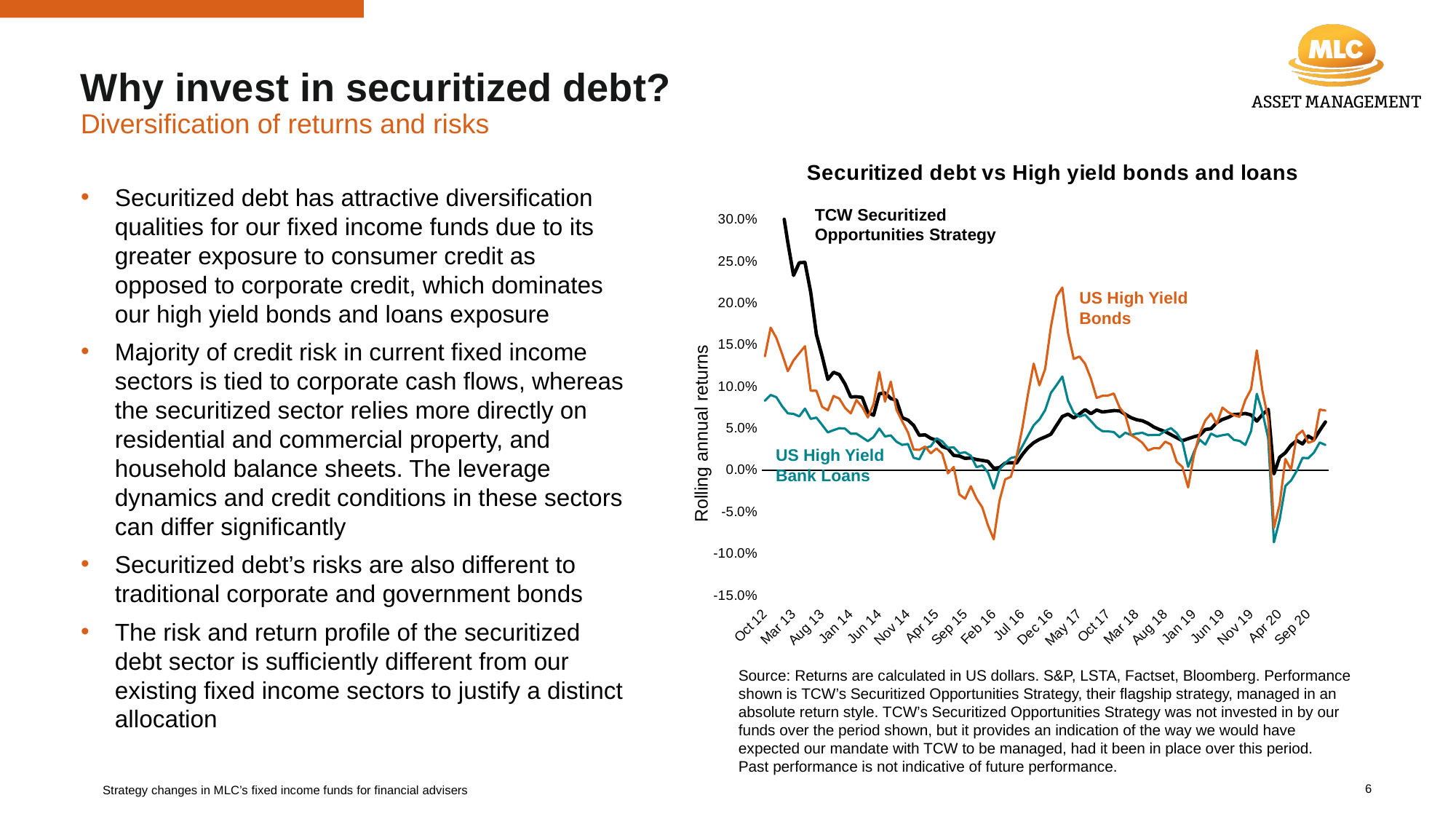
Is the value for TCW Securitized Opportunities Strategy at Oct 12 greater or less than 25.0%? greater Is the lowest value for US High Yield Bonds around Feb 16 greater or less than -5.0%? less At Oct 12, which is higher: TCW Securitized Opportunities Strategy or US High Yield Bank Loans? TCW Securitized Opportunities Strategy Which series reaches the highest value anywhere on the chart? TCW Securitized Opportunities Strategy What kind of chart is shown on the slide? line chart Does the TCW Securitized Opportunities Strategy line rise or fall from Oct 12 to Feb 16? fall Is the peak value for US High Yield Bonds around May 17 greater or less than 15.0%? greater Around May 17, which is higher: US High Yield Bonds or TCW Securitized Opportunities Strategy? US High Yield Bonds How many series are plotted on the chart? 3 What is the title of the chart? Securitized debt vs High yield bonds and loans What is the label on the vertical axis of the chart? Rolling annual returns